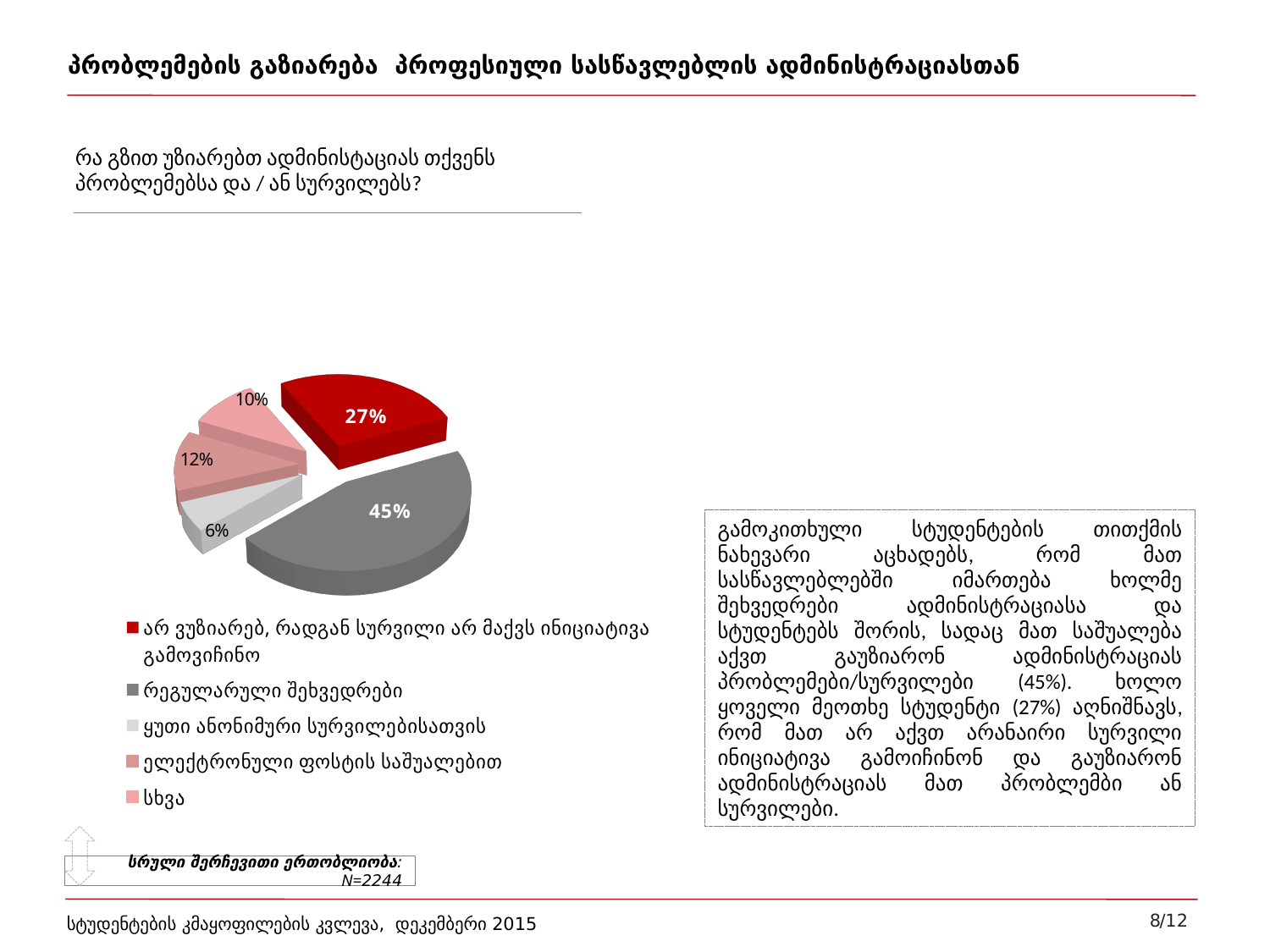
What share of the pie does "ელექტრონული ფოსტის საშუალებით" have? 12% How many slices does the pie chart have? 5 Which category has the smallest slice of the pie? ყუთი ანონიმური სურვილებისათვის What share of the pie does "არ ვუზიარებ, რადგან სურვილი არ მაქვს ინიციატივა გამოვიჩინო" have? 27% What colour is the slice for "რეგულარული შეხვედრები"? dark gray Which category has the largest slice of the pie? რეგულარული შეხვედრები What share of the pie does "რეგულარული შეხვედრები" have? 45% Which is larger: the slice for "ელექტრონული ფოსტის საშუალებით" or the slice for "სხვა"? ელექტრონული ფოსტის საშუალებით What share of the pie does "ყუთი ანონიმური სურვილებისათვის" have? 6% What kind of chart is shown on the slide? pie chart What share of the pie does "სხვა" have? 10% What is the difference in percentage points between "რეგულარული შეხვედრები" and "არ ვუზიარებ, რადგან სურვილი არ მაქვს ინიციატივა გამოვიჩინო"? 18 percentage points